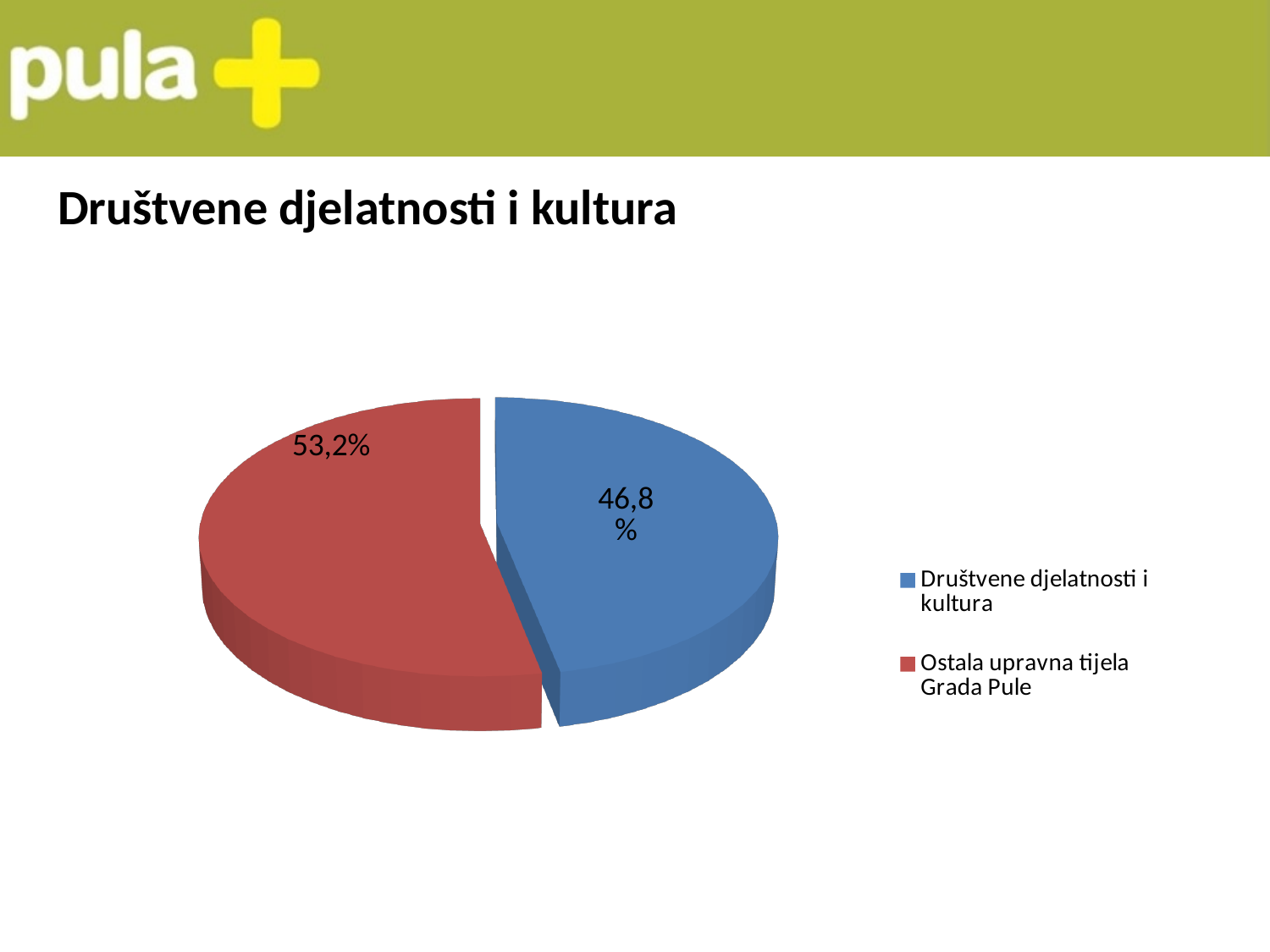
Which slice is the smallest? Društvene djelatnosti i kultura How many entries does the legend list? 2 How many slices does the pie chart have? 2 Which slice is the largest? Ostala upravna tijela Grada Pule What is the title of the slide? Društvene djelatnosti i kultura What colour is the slice for "Društvene djelatnosti i kultura"? Blue What kind of chart is shown on the slide? Pie chart Which is larger: "Društvene djelatnosti i kultura" or "Ostala upravna tijela Grada Pule"? Ostala upravna tijela Grada Pule What share of the pie does "Ostala upravna tijela Grada Pule" have? 53,2% What is the difference in percentage points between "Ostala upravna tijela Grada Pule" and "Društvene djelatnosti i kultura"? 6,4 Is the share for "Društvene djelatnosti i kultura" greater or less than 50%? less What share of the pie does "Društvene djelatnosti i kultura" have? 46,8%